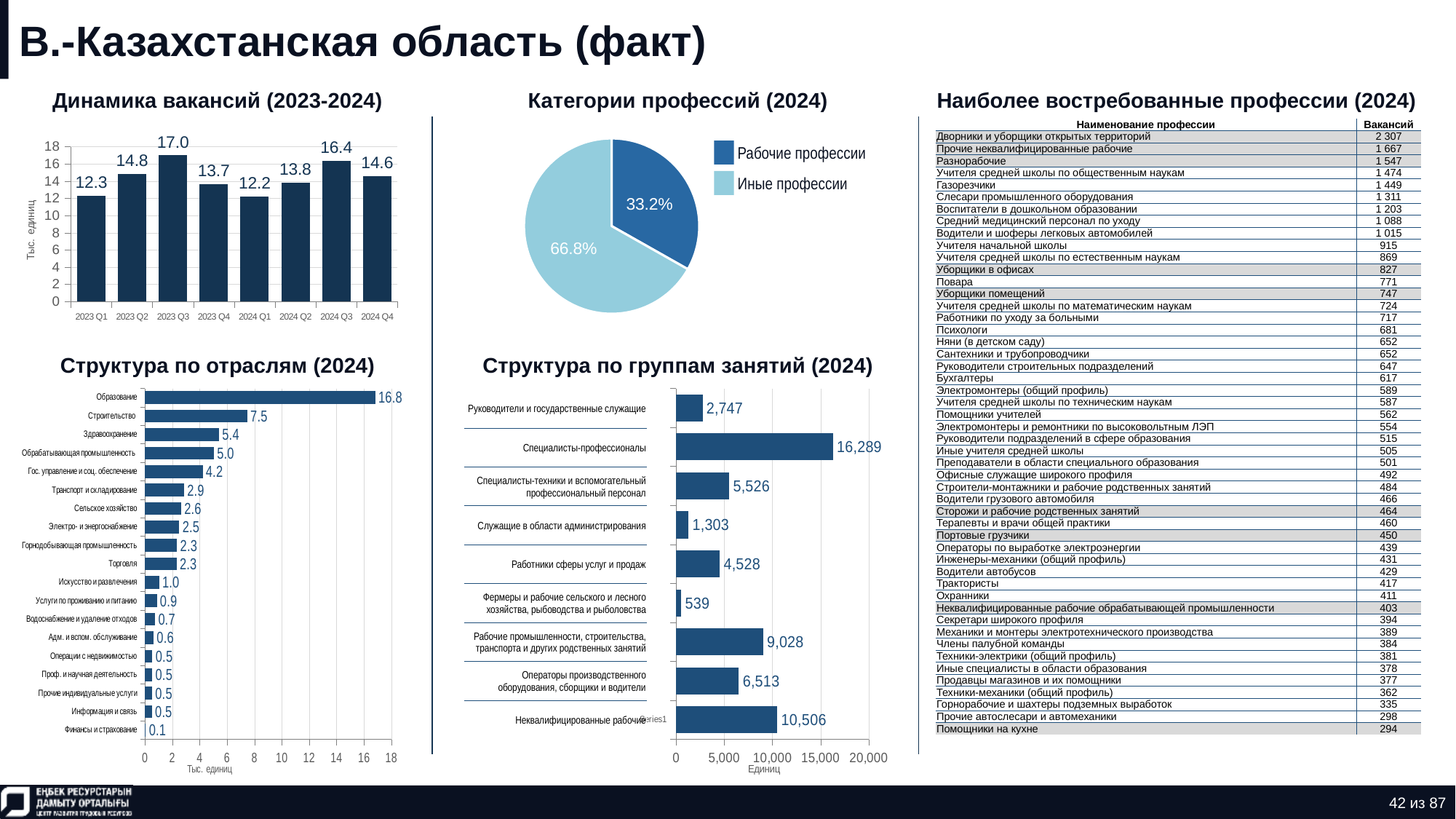
In the chart 'Динамика вакансий (2023-2024)', how many quarters are plotted? 8 In the chart 'Структура по группам занятий (2024)', which category has the lowest value? Фермеры и рабочие сельского и лесного хозяйства, рыбоводства и рыболовства In the chart 'Динамика вакансий (2023-2024)', what is the value for 2023 Q3? 17.0 In the chart 'Динамика вакансий (2023-2024)', which quarter has the lowest value? 2024 Q1 What kind of chart is 'Категории профессий (2024)'? Pie chart In the chart 'Структура по отраслям (2024)', which category has the highest value? Образование In the chart 'Структура по группам занятий (2024)', how many categories are plotted? 9 In the chart 'Категории профессий (2024)', what share does 'Рабочие профессии' have? 33.2% In the chart 'Структура по отраслям (2024)', what is the value for 'Строительство'? 7.5 In the chart 'Структура по группам занятий (2024)', what is the value for 'Операторы производственного оборудования, сборщики и водители'? 6,513 In the chart 'Динамика вакансий (2023-2024)', what is the difference between 2024 Q3 and 2024 Q1? 4.2 In the chart 'Структура по отраслям (2024)', which is larger: 'Здравоохранение' or 'Транспорт и складирование'? Здравоохранение